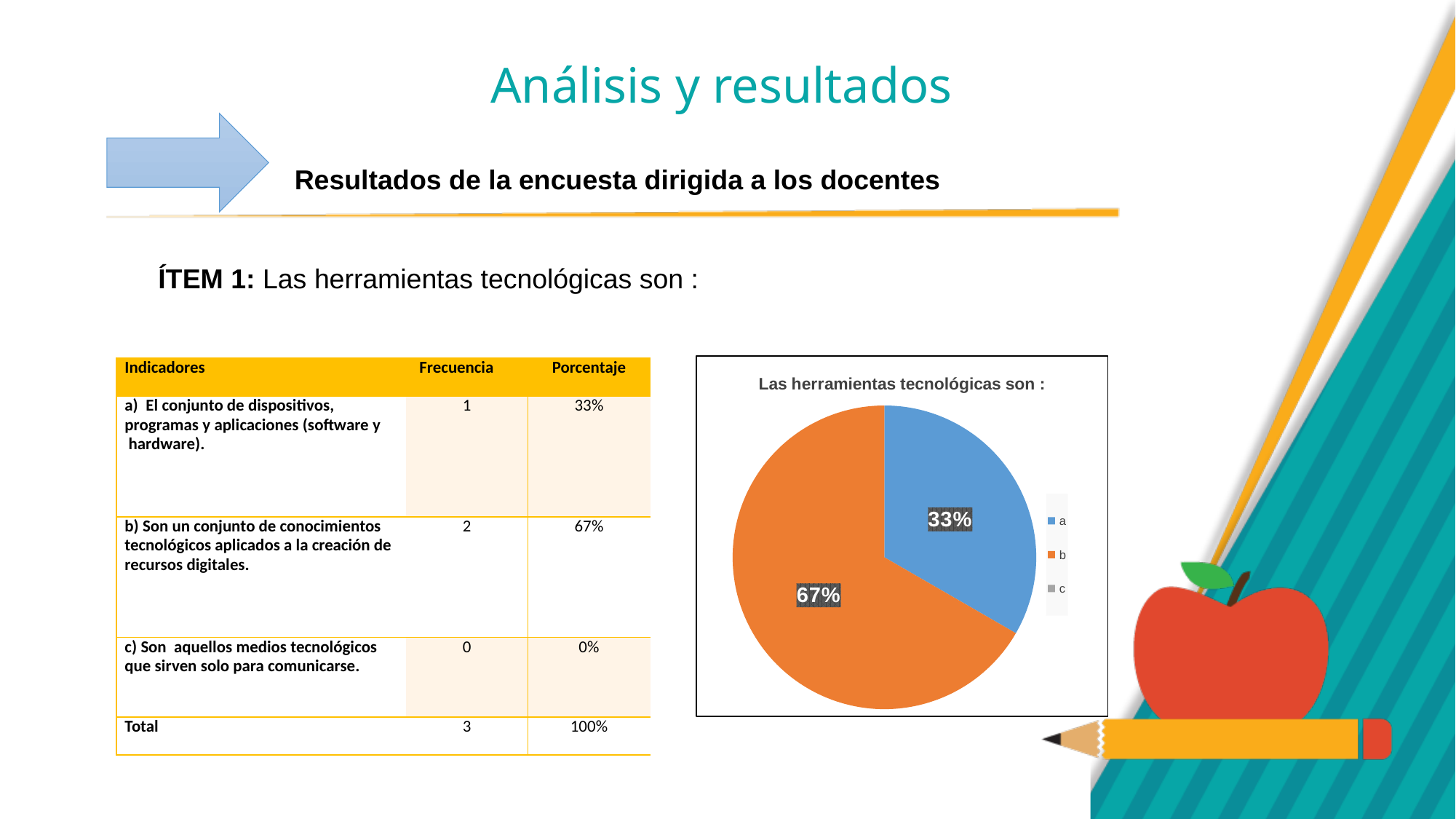
Is the value for slice b in the pie chart greater or less than 50%? greater Which category has the largest slice in the pie chart? b What percentage does slice a show in the pie chart? 33% Which is larger in the pie chart, slice a or slice b? b How many slices are visible in the pie chart? 2 What is the title of the pie chart? Las herramientas tecnológicas son : What colour is slice b in the pie chart? orange How many entries does the legend of the pie chart list? 3 What is the difference in percentage points between slice b and slice a in the pie chart? 34 What kind of chart is shown on the slide? pie chart What percentage does slice b show in the pie chart? 67%